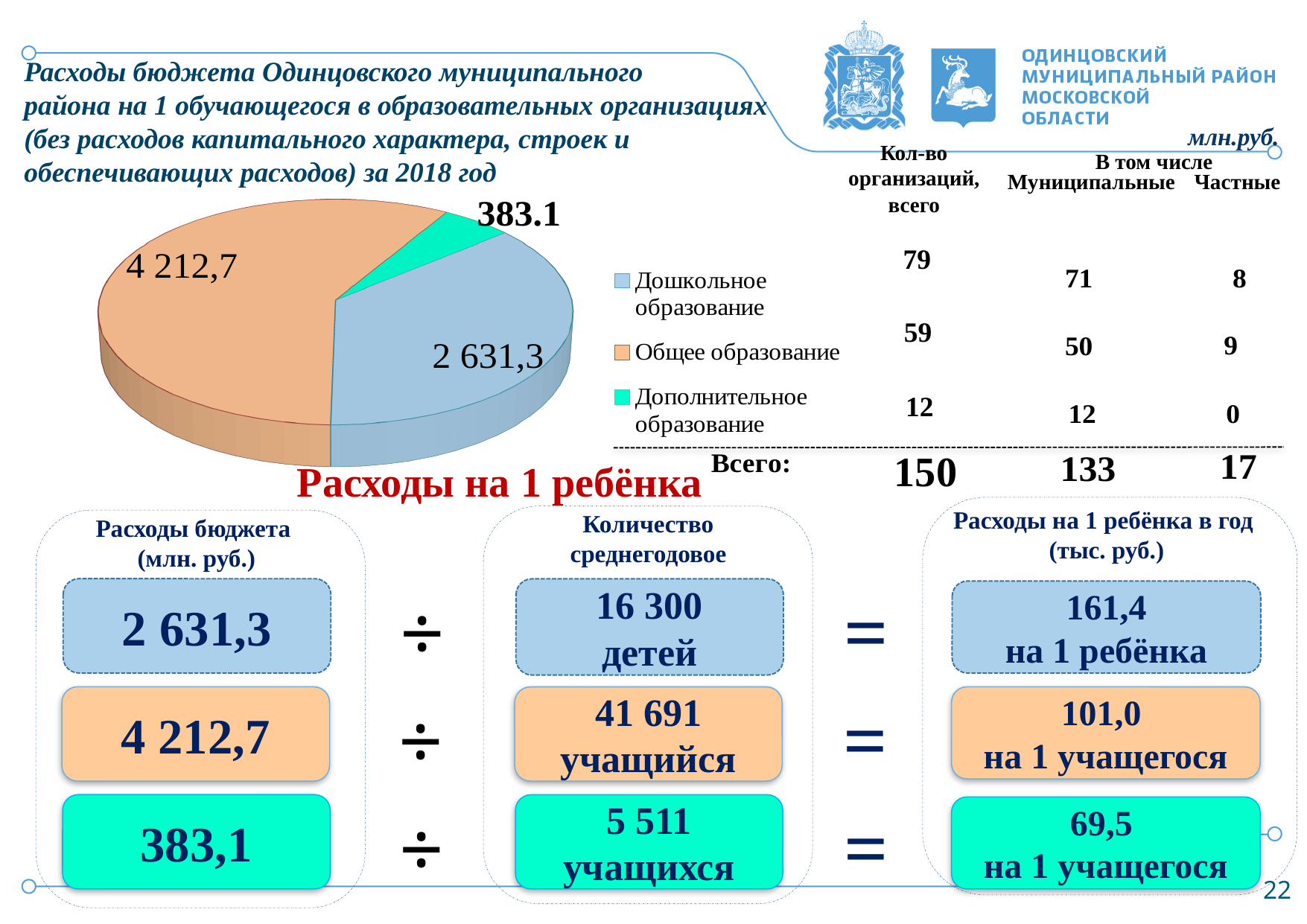
What is the difference between the pie chart values for Общее образование and Дошкольное образование? 1 581,4 Which category has the smallest slice in the pie chart? Дополнительное образование How many entries does the pie chart legend list? 3 What value does the pie chart show for Общее образование? 4 212,7 How many slices does the pie chart have? 3 What colour is the Общее образование slice in the pie chart? Orange What type of chart is shown on the slide? Pie chart In the pie chart, which is larger: Дошкольное образование or Дополнительное образование? Дошкольное образование What value does the pie chart show for Дошкольное образование? 2 631,3 Which category has the largest slice in the pie chart? Общее образование What is the total of all three values shown in the pie chart? 7 227,1 What value does the pie chart show for Дополнительное образование? 383.1